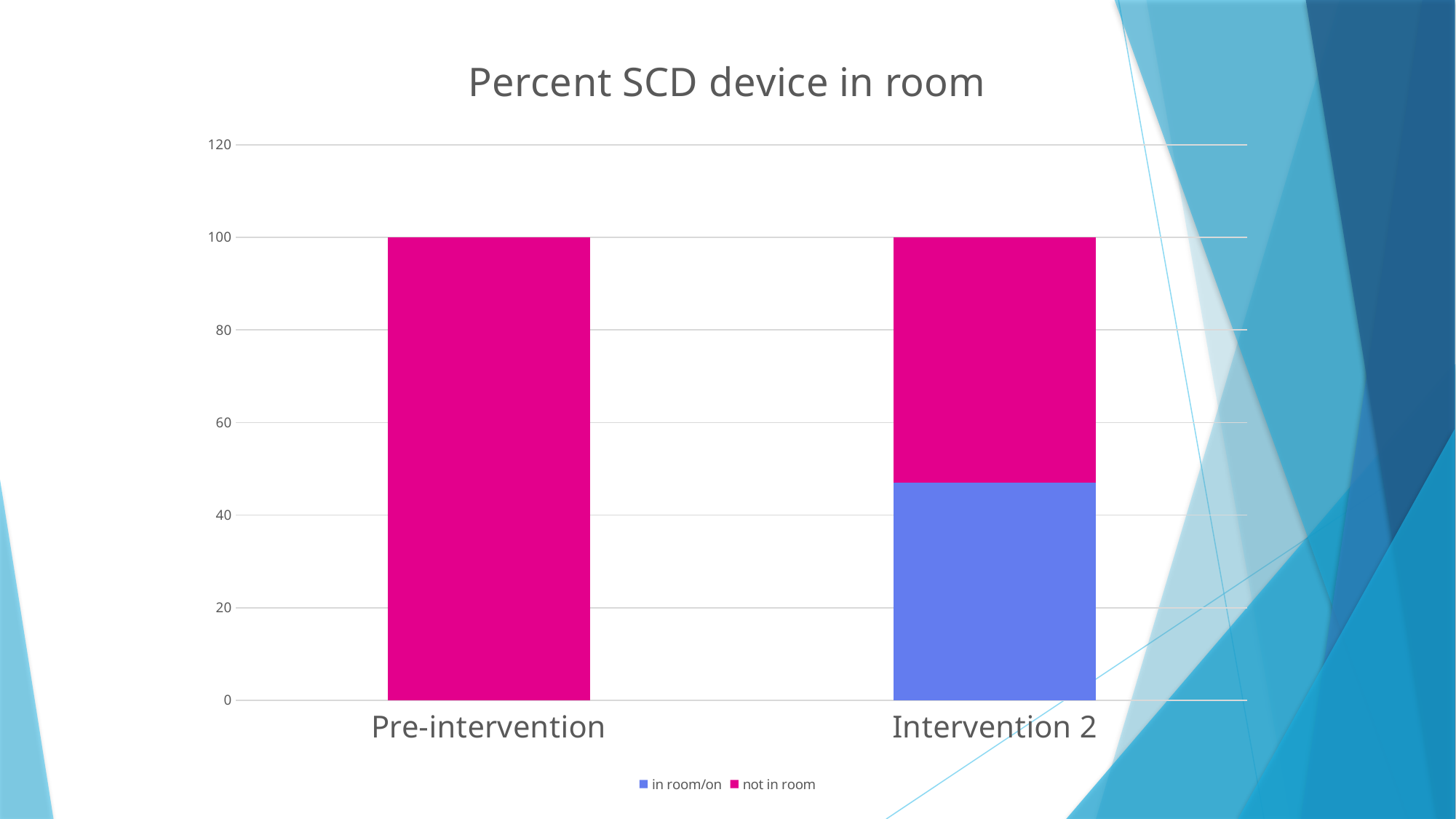
How many series does the legend list? 2 Does the 'not in room' value rise or fall from Pre-intervention to Intervention 2? Fall What is the value of 'not in room' for Pre-intervention? 100 Is the value of 'in room/on' for Intervention 2 greater or less than 60? less Which colour represents the 'in room/on' series? Blue What is the total height of the stacked bar for Pre-intervention? 100 What kind of chart is shown on the slide? Stacked bar chart Is the value of 'in room/on' for Intervention 2 greater or less than 40? greater What is the total height of the stacked bar for Intervention 2? 100 What is the title of the chart? Percent SCD device in room Which category has the larger 'in room/on' value, Pre-intervention or Intervention 2? Intervention 2 How many categories are shown on the x axis? 2